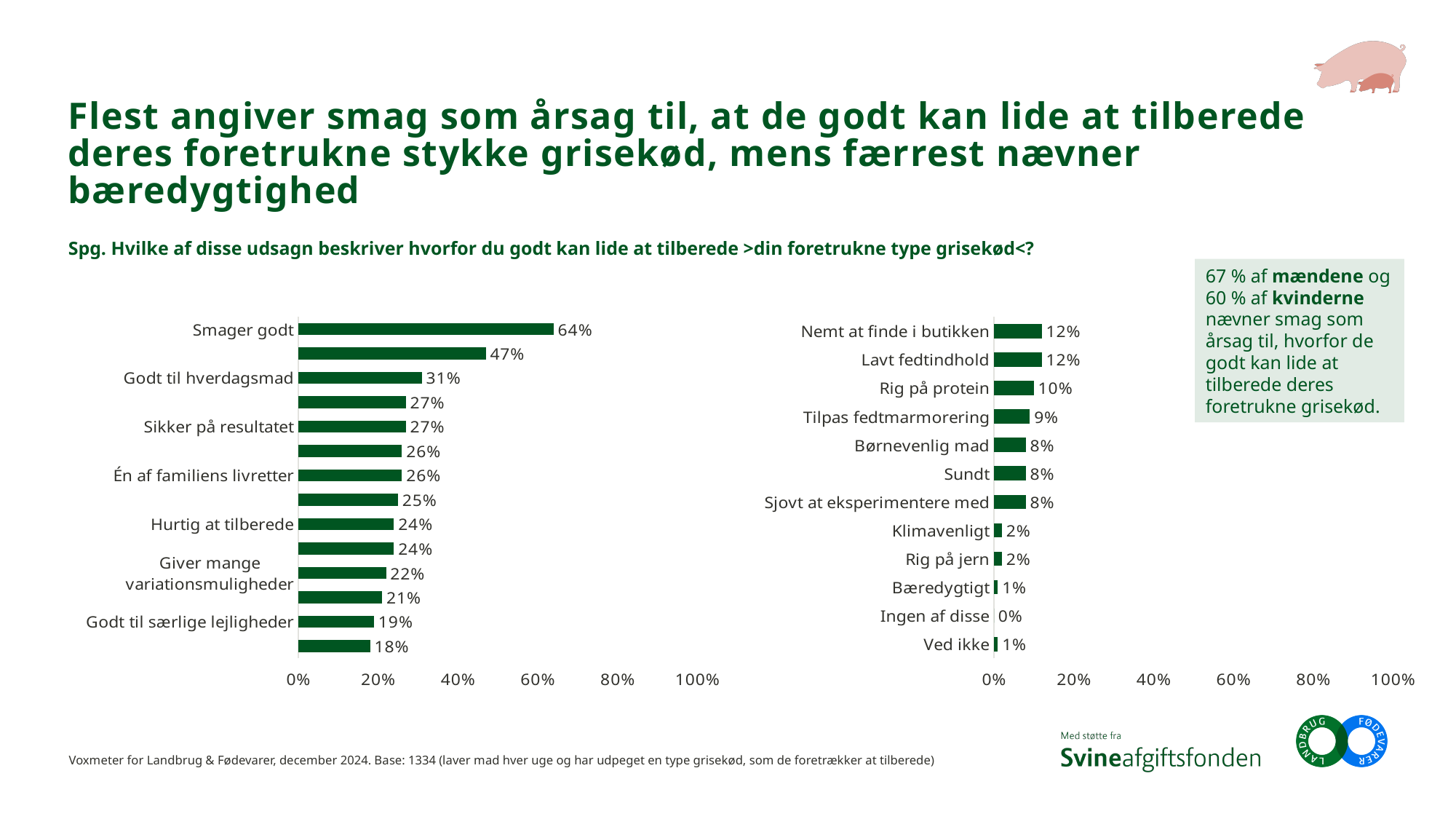
In the left chart, what is the difference between "Smager godt" and "Godt til hverdagsmad"? 33 percentage points In the left chart, is the value for "Smager godt" greater or less than 60%? greater In the right chart, which category has the lowest value? Ingen af disse In the left chart, which is larger: "Hurtig at tilberede" or "Giver mange variationsmuligheder"? Hurtig at tilberede In the right chart, what is the value for "Rig på protein"? 10% How many categories are shown in the right chart? 12 In the left chart, which labelled category has the highest value? Smager godt In the right chart, what is the difference between "Nemt at finde i butikken" and "Tilpas fedtmarmorering"? 3 percentage points What type of chart is used on this slide? Bar chart In the left chart, what percentage is shown for "Smager godt"? 64% In the right chart, what percentage is shown for "Bæredygtigt"? 1% In the left chart, what is the value for "Godt til hverdagsmad"? 31%